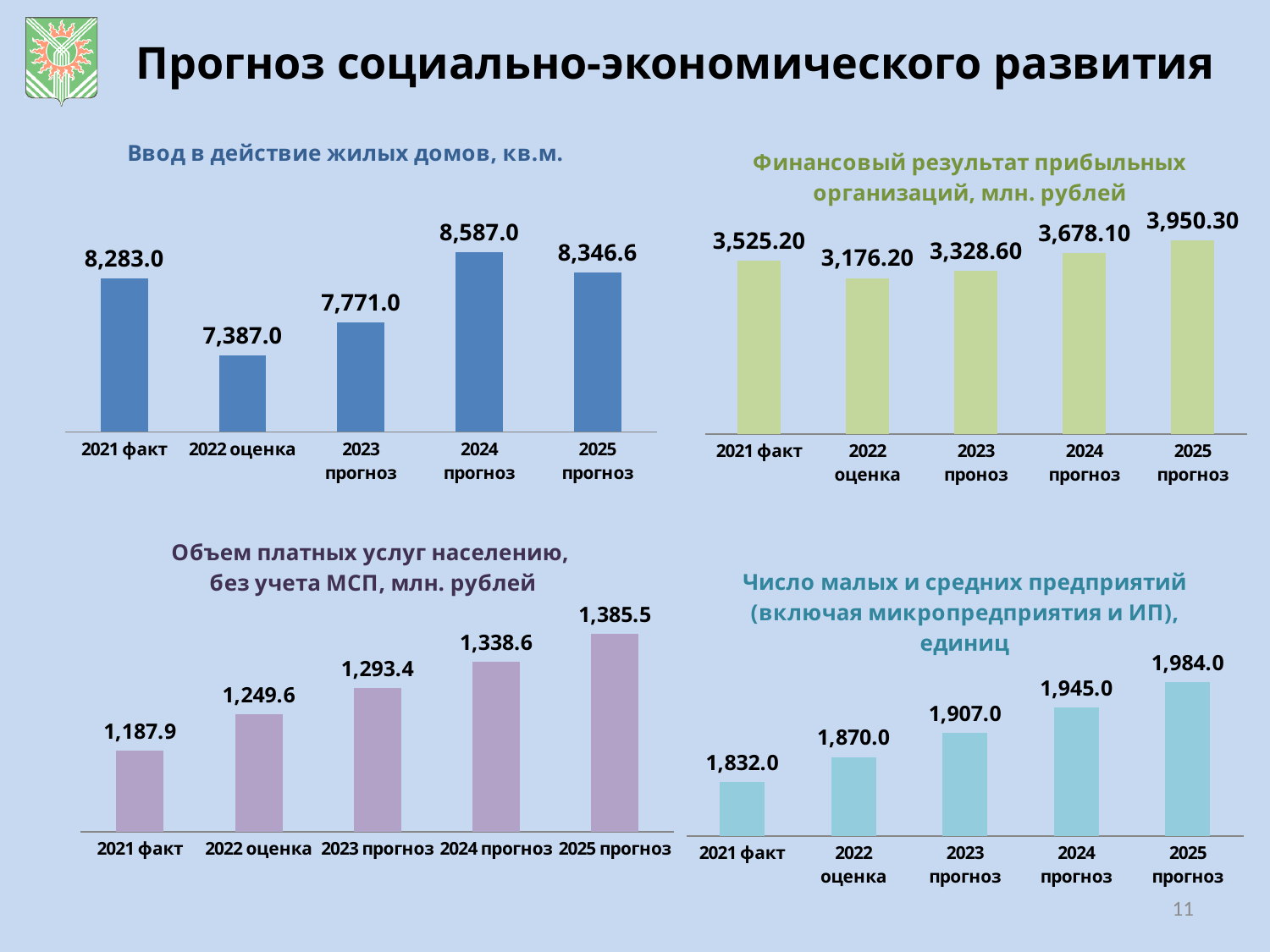
In the chart 'Число малых и средних предприятий (включая микропредприятия и ИП), единиц', what is the difference between the 2025 прогноз and 2024 прогноз values? 39.0 In the chart 'Финансовый результат прибыльных организаций, млн. рублей', which category has the lowest value? 2022 оценка In the chart 'Объем платных услуг населению, без учета МСП, млн. рублей', do the values rise or fall from 2021 факт to 2025 прогноз? rise In the chart 'Финансовый результат прибыльных организаций, млн. рублей', how much higher is the 2025 прогноз value than the 2021 факт value? 425.10 In the chart 'Объем платных услуг населению, без учета МСП, млн. рублей', how many categories are shown? 5 In the chart 'Ввод в действие жилых домов, кв.м.', which category has the highest value? 2024 прогноз In the chart 'Объем платных услуг населению, без учета МСП, млн. рублей', what is the value for 2025 прогноз? 1,385.5 In the chart 'Ввод в действие жилых домов, кв.м.', what is the value for 2022 оценка? 7,387.0 What type of chart is 'Число малых и средних предприятий (включая микропредприятия и ИП), единиц'? bar chart In the chart 'Финансовый результат прибыльных организаций, млн. рублей', what is the value for 2023 проноз? 3,328.60 In the chart 'Число малых и средних предприятий (включая микропредприятия и ИП), единиц', what is the value for 2021 факт? 1,832.0 In the chart 'Ввод в действие жилых домов, кв.м.', what is the difference between the 2024 прогноз and 2021 факт values? 304.0